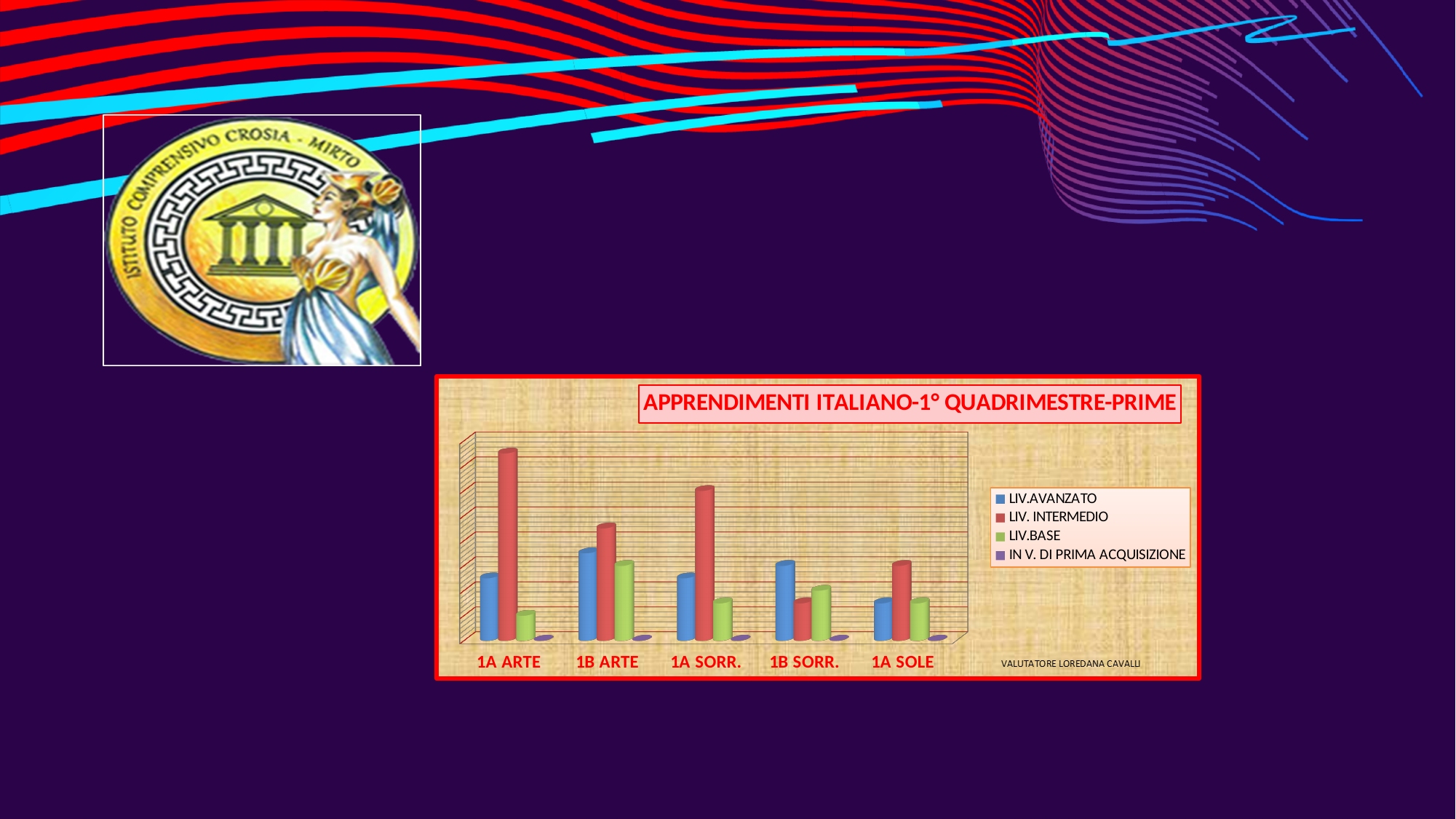
How many classes (categories) are shown on the x axis of the chart? 5 For 1A ARTE, which is larger: LIV.AVANZATO or LIV. INTERMEDIO? LIV. INTERMEDIO For 1A SORR., which series has the tallest bar? LIV. INTERMEDIO What is the title of the chart? APPRENDIMENTI ITALIANO-1° QUADRIMESTRE-PRIME Which class has the highest LIV. INTERMEDIO bar? 1A ARTE Which class has the lowest LIV.AVANZATO bar? 1A SOLE Which class has the lowest LIV. INTERMEDIO bar? 1B SORR. For 1B SORR., which is larger: LIV.AVANZATO or LIV. INTERMEDIO? LIV.AVANZATO How many series does the chart legend list? 4 What kind of chart is shown on the slide? Bar chart Which series is shown in red in the chart? LIV. INTERMEDIO Which class has the highest LIV.BASE bar? 1B ARTE